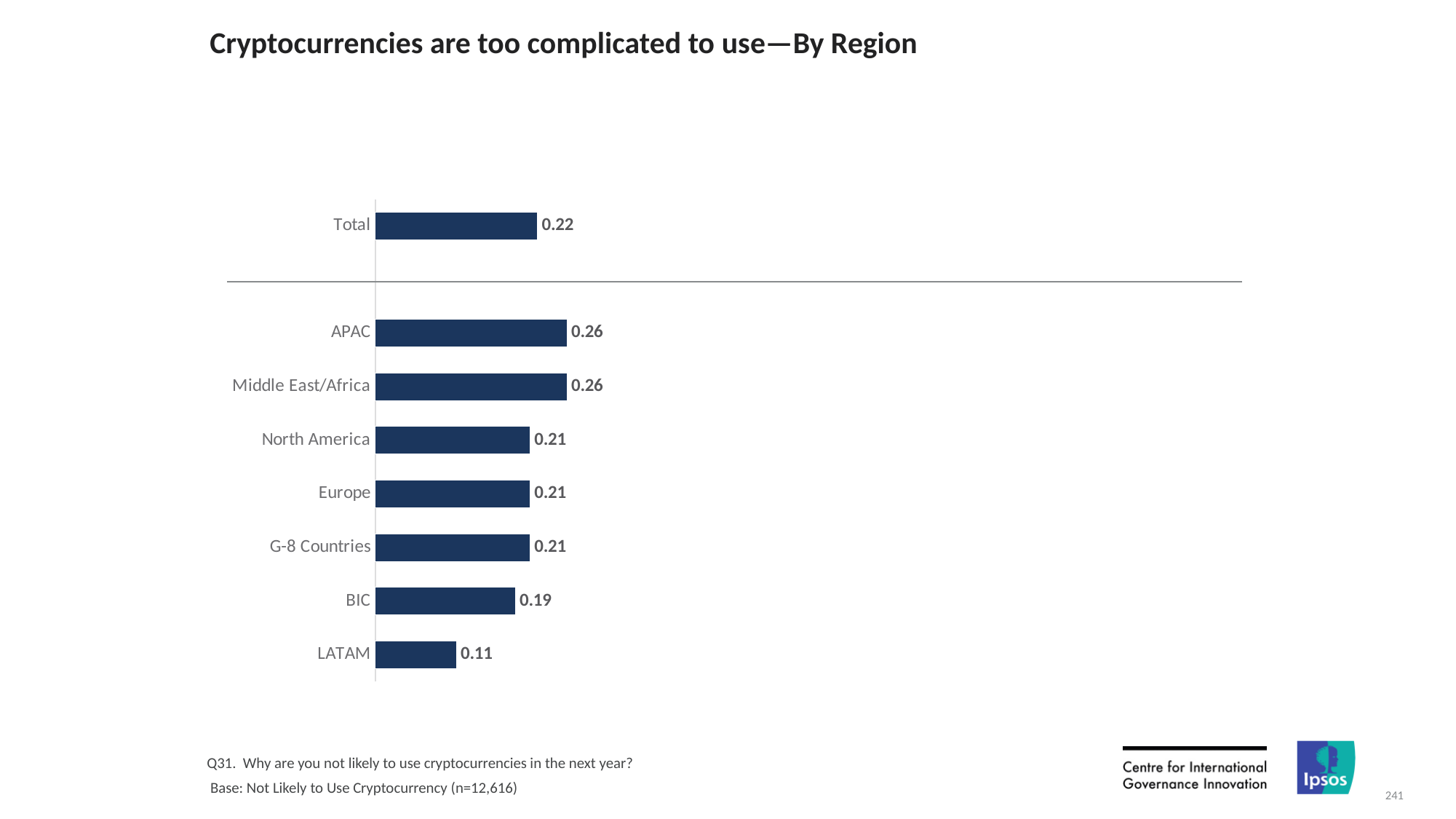
Which region has the lowest value? LATAM What is the value for BIC? 0.19 How many bars are shown in the chart, including Total? 8 What is the value for LATAM? 0.11 What is the value for Middle East/Africa? 0.26 What is the value for Total? 0.22 What is the difference between the values for APAC and LATAM? 0.15 What kind of chart is shown on the slide? Bar chart What is the difference between the values for Total and BIC? 0.03 Which is larger, the value for North America or the value for BIC? North America What is the title of the chart? Cryptocurrencies are too complicated to use—By Region Which is larger, the value for LATAM or the value for Europe? Europe